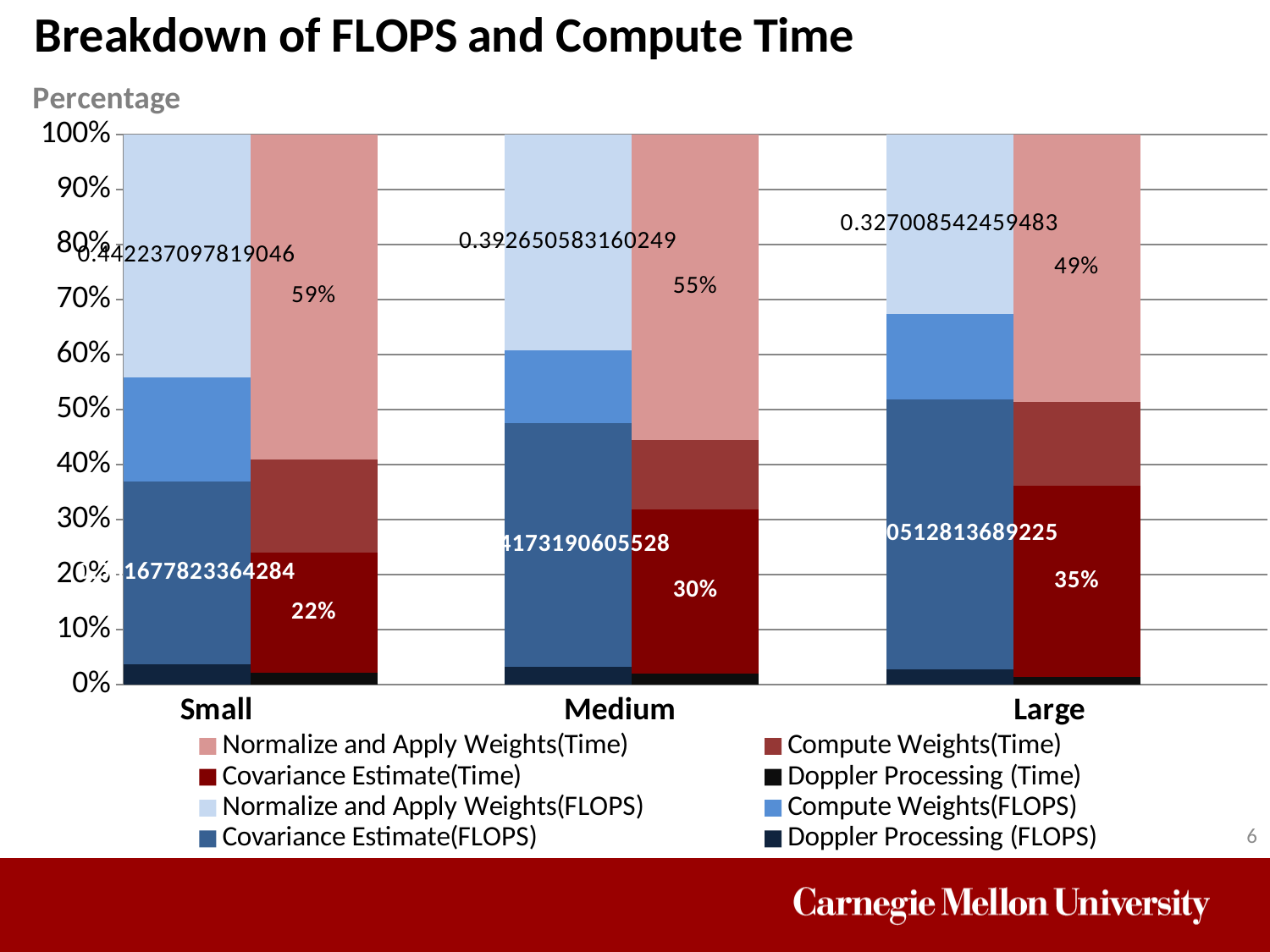
How many categories are shown on the x axis? 3 What is the title of the chart? Breakdown of FLOPS and Compute Time What is the data label for Normalize and Apply Weights(FLOPS) for Medium? 0.392650583160249 How many series does the legend list? 8 Which category has the highest value for Normalize and Apply Weights(Time)? Small What is the value of Normalize and Apply Weights(Time) for Small? 59% What is the value of Covariance Estimate(Time) for Large? 35% What is the difference between the Normalize and Apply Weights(Time) values for Small and Large? 10% Which category has the lowest value for Covariance Estimate(Time)? Small Does the Normalize and Apply Weights(Time) value rise or fall from Small to Large? Fall What kind of chart is shown on the slide? Stacked bar chart Which is larger, Covariance Estimate(Time) for Medium or for Large? Large